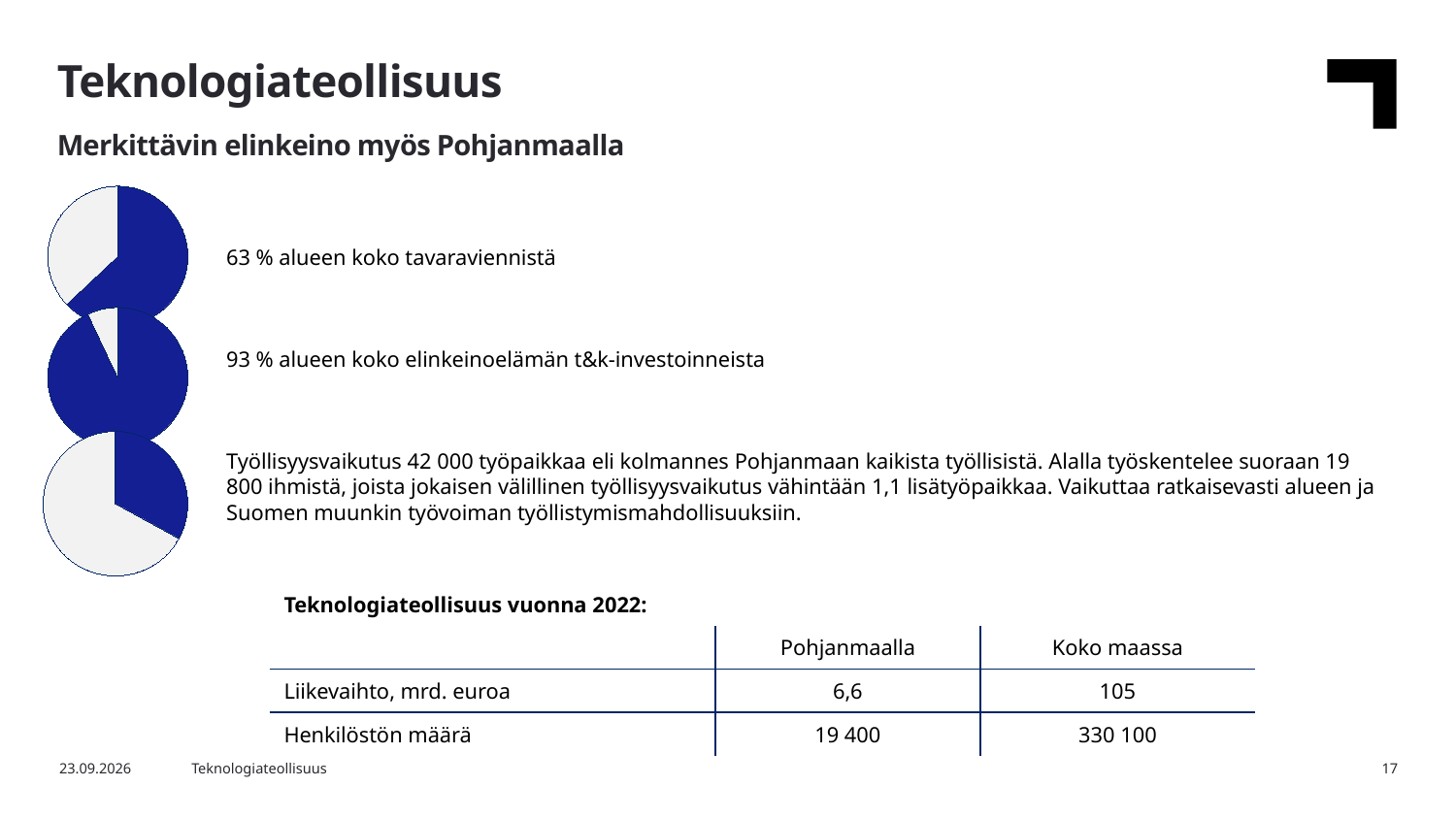
Which of the three pie charts has the smallest blue slice? The bottom pie chart (employment effect) In the bottom pie chart, is the blue slice larger or smaller than the grey slice? Smaller Which of the three pie charts has the largest blue slice? The middle pie chart (93 % of R&D investments) According to the text next to the bottom pie chart, what fraction of all employed people in Pohjanmaa does the technology industry's employment effect represent? Kolmannes (one third) According to the text next to the middle pie chart, what share of the region's business R&D investments (t&k-investoinnit) does the blue slice represent? 93 % In the top pie chart, is the blue slice larger or smaller than the grey slice? Larger How many pie charts are on the slide? 3 What kind of charts are shown on the left side of the slide? Pie charts According to the text next to the top pie chart, what share of the region's total goods exports (tavaravienti) does the blue slice represent? 63 % What is the difference in percentage points between the share shown for the middle pie chart (93 %) and the top pie chart (63 %)? 30 percentage points Is the blue share in the middle pie chart greater or less than the blue share in the top pie chart? Greater What colour is used for the highlighted slice in each pie chart? Dark blue